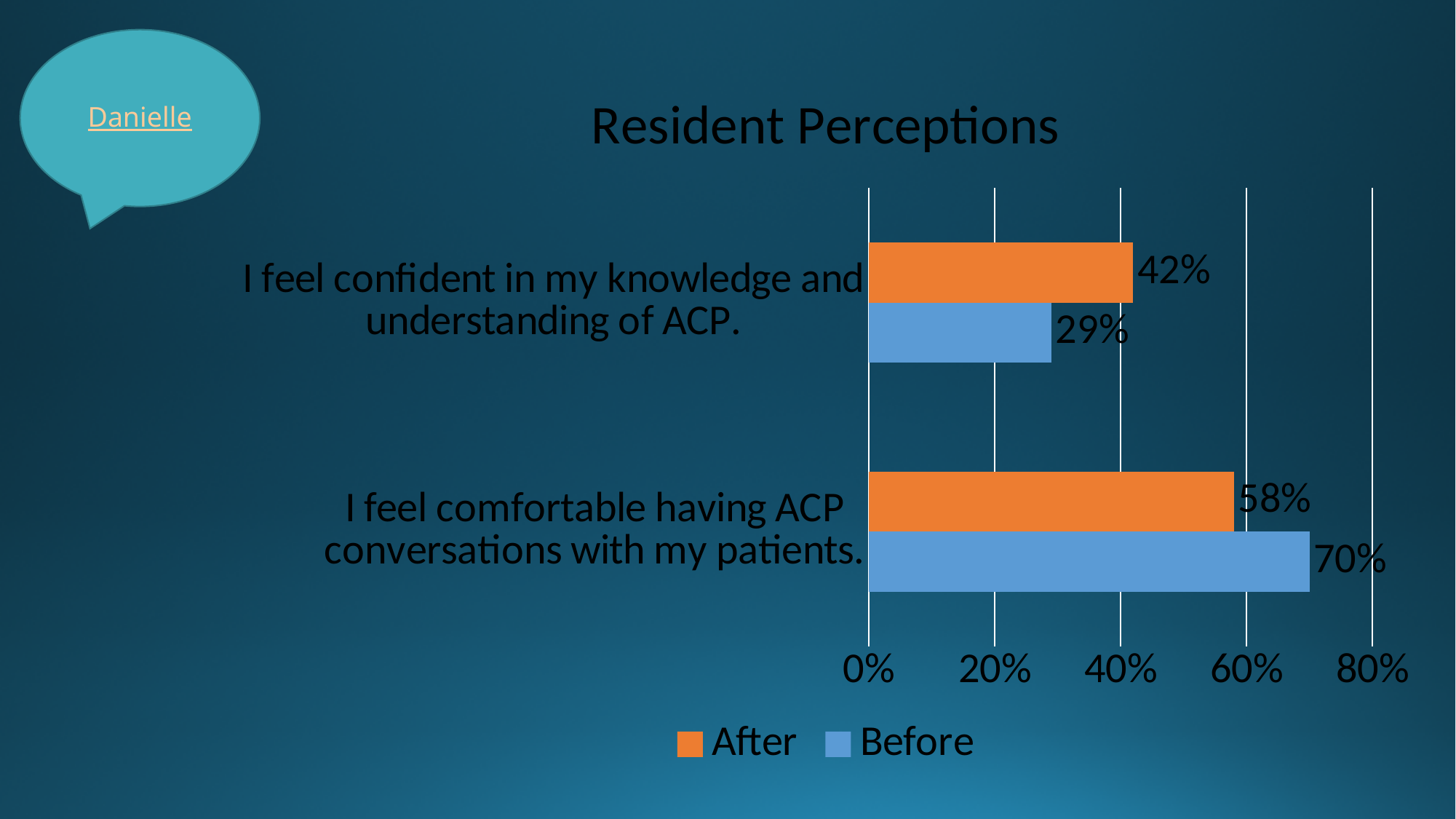
What is the difference between the 'After' and 'Before' values for 'I feel confident in my knowledge and understanding of ACP.'? 13% What is the 'Before' value for 'I feel comfortable having ACP conversations with my patients.'? 70% What kind of chart is shown on the slide? Bar chart What is the 'After' value for 'I feel confident in my knowledge and understanding of ACP.'? 42% What is the difference between the 'Before' and 'After' values for 'I feel comfortable having ACP conversations with my patients.'? 12% How many series does the legend list? 2 Which category has the lowest 'After' value? I feel confident in my knowledge and understanding of ACP. What is the 'Before' value for 'I feel confident in my knowledge and understanding of ACP.'? 29% How many categories are shown in the chart? 2 What is the 'After' value for 'I feel comfortable having ACP conversations with my patients.'? 58% Which category has the highest 'Before' value? I feel comfortable having ACP conversations with my patients. For 'I feel comfortable having ACP conversations with my patients.', which is larger, the 'Before' or 'After' value? Before